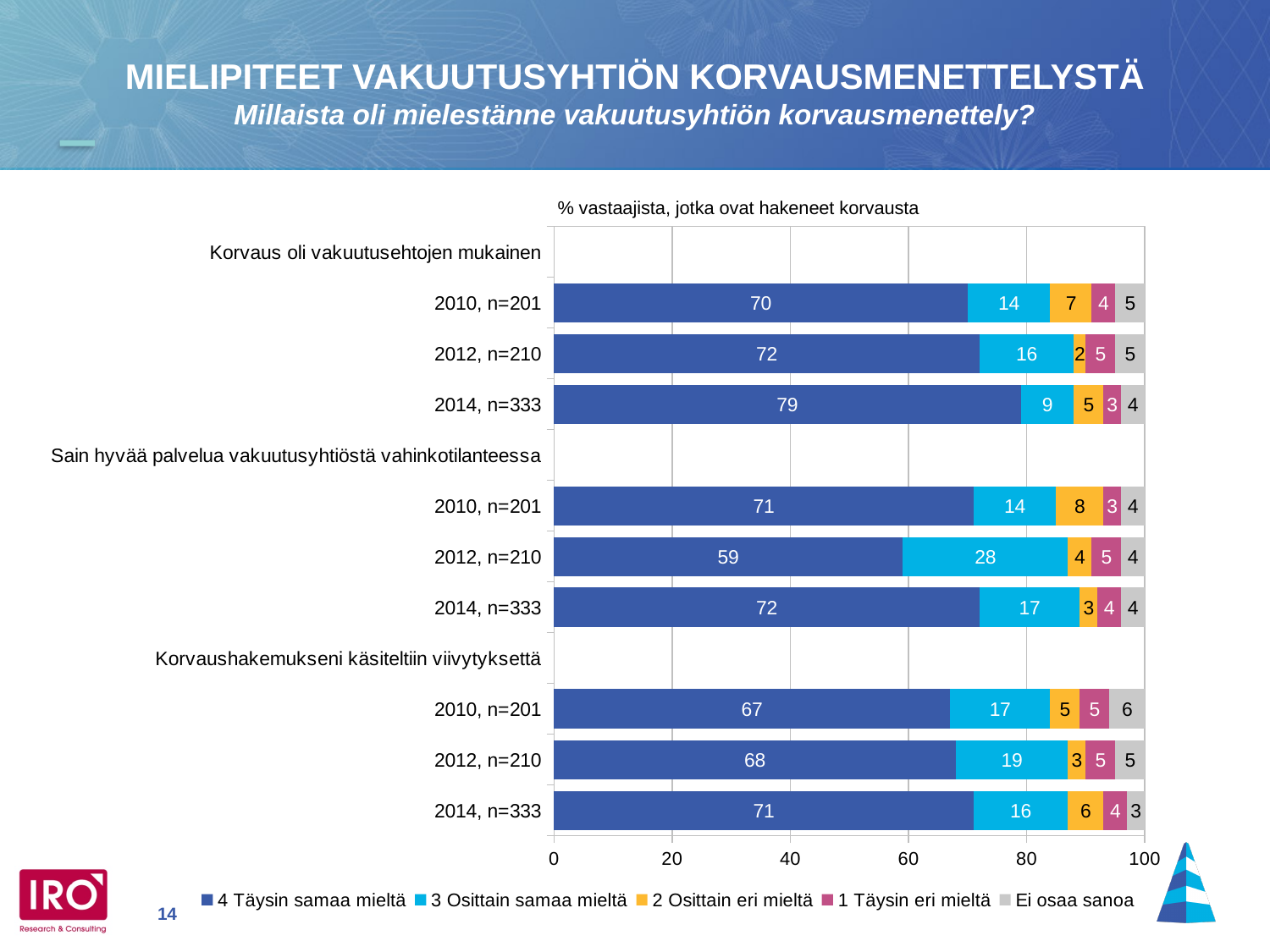
How many data bars (year rows) are plotted in the chart? 9 What is the total of the stacked bar for 'Sain hyvää palvelua vakuutusyhtiöstä vahinkotilanteessa' in 2010, n=201? 100 For 'Korvaus oli vakuutusehtojen mukainen', does the '4 Täysin samaa mieltä' value rise or fall from 2010 to 2014? rise Which year row has the highest '4 Täysin samaa mieltä' value across the whole chart? Korvaus oli vakuutusehtojen mukainen, 2014, n=333 How many series does the legend list? 5 What is the difference between the '4 Täysin samaa mieltä' values for 'Korvaus oli vakuutusehtojen mukainen' in 2014, n=333 and 2010, n=201? 9 Which year row has the lowest '4 Täysin samaa mieltä' value across the whole chart? Sain hyvää palvelua vakuutusyhtiöstä vahinkotilanteessa, 2012, n=210 What is the value of '4 Täysin samaa mieltä' for 'Korvaus oli vakuutusehtojen mukainen' in 2014, n=333? 79 What type of chart is shown on the slide? stacked bar chart What is the value of 'Ei osaa sanoa' for 'Korvaushakemukseni käsiteltiin viivytyksettä' in 2010, n=201? 6 For 'Korvaushakemukseni käsiteltiin viivytyksettä', is the '3 Osittain samaa mieltä' value larger in 2012, n=210 or in 2014, n=333? 2012, n=210 What is the value of '3 Osittain samaa mieltä' for 'Sain hyvää palvelua vakuutusyhtiöstä vahinkotilanteessa' in 2012, n=210? 28